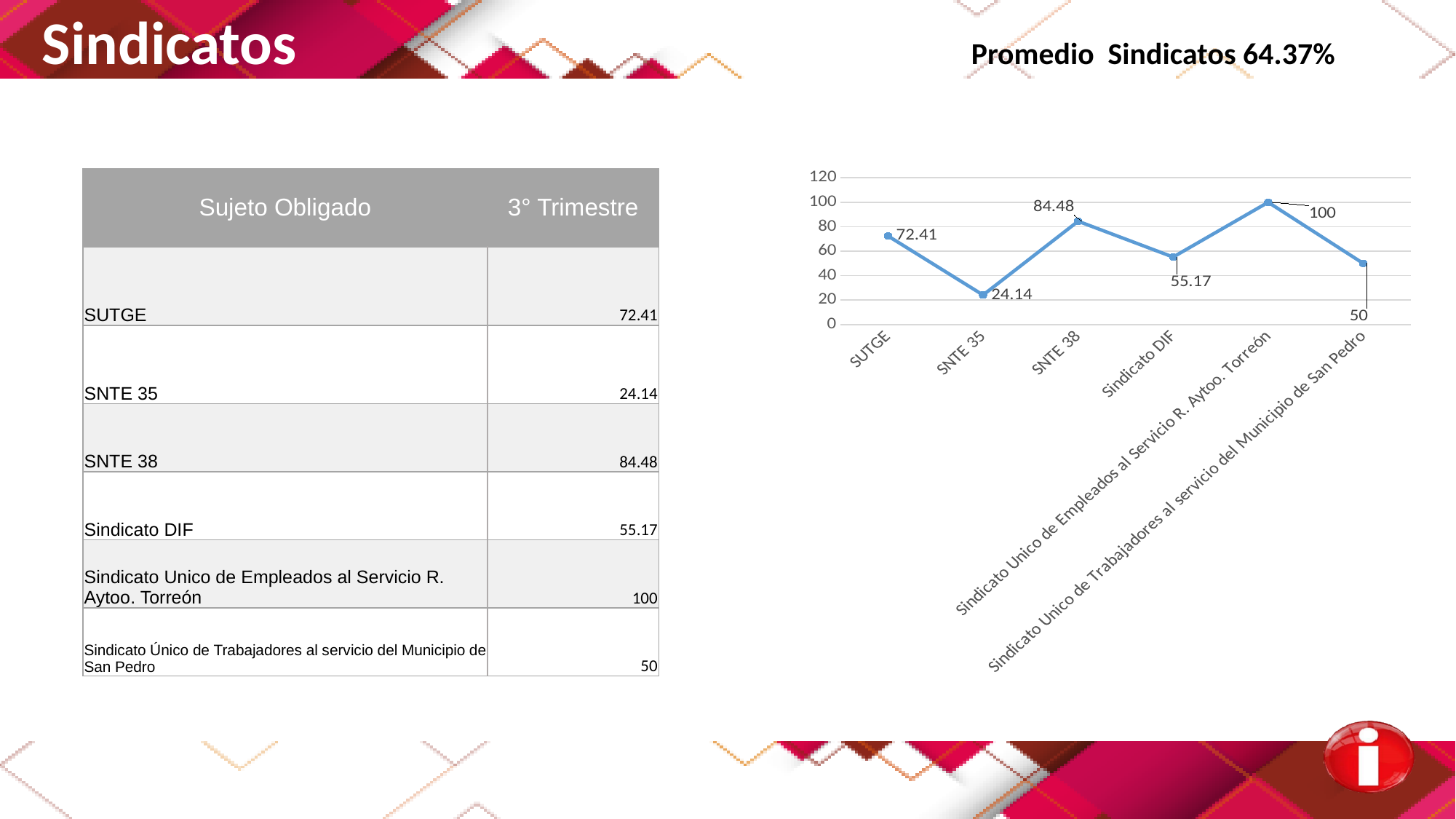
What kind of chart is shown on the slide? line chart What is the value for SUTGE in the line chart? 72.41 Which category has the lowest value in the line chart? SNTE 35 How many categories are plotted on the x axis of the line chart? 6 What is the difference between the values for SNTE 38 and SNTE 35? 60.34 Which category has the highest value in the line chart? Sindicato Unico de Empleados al Servicio R. Aytoo. Torreón What is the value for Sindicato DIF in the line chart? 55.17 Does the line rise or fall between Sindicato Unico de Empleados al Servicio R. Aytoo. Torreón and Sindicato Unico de Trabajadores al servicio del Municipio de San Pedro? fall Which has a larger value, SUTGE or Sindicato DIF? SUTGE What is the value for SNTE 35 in the line chart? 24.14 Is the value for SNTE 38 greater or less than 80? greater What is the value for Sindicato Unico de Trabajadores al servicio del Municipio de San Pedro in the line chart? 50